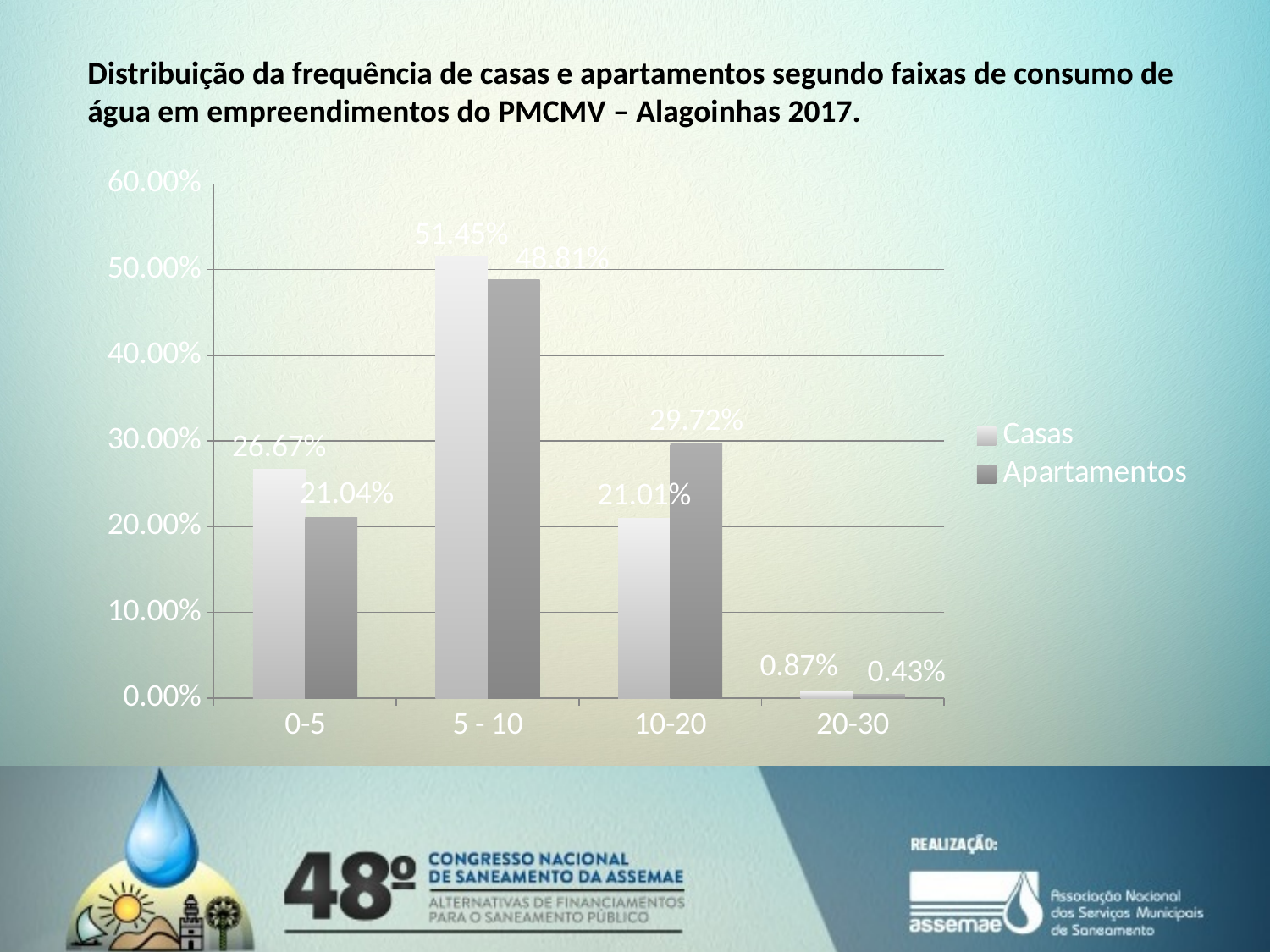
What is the difference between Casas and Apartamentos in the 0-5 consumption range? 5.63% What is the value for Casas in the 5 - 10 consumption range? 51.45% How many series does the legend list? 2 What is the value for Apartamentos in the 10-20 consumption range? 29.72% What are the two series named in the legend? Casas and Apartamentos In the 10-20 consumption range, which series has the larger value, Casas or Apartamentos? Apartamentos How many consumption ranges are shown on the x axis? 4 Is the value for Apartamentos in the 5 - 10 range greater or less than 40.00%? greater What kind of chart is shown on the slide? Bar chart Which consumption range has the lowest value for Casas? 20-30 What is the value for Casas in the 20-30 consumption range? 0.87% Which consumption range has the highest value for Apartamentos? 5 - 10